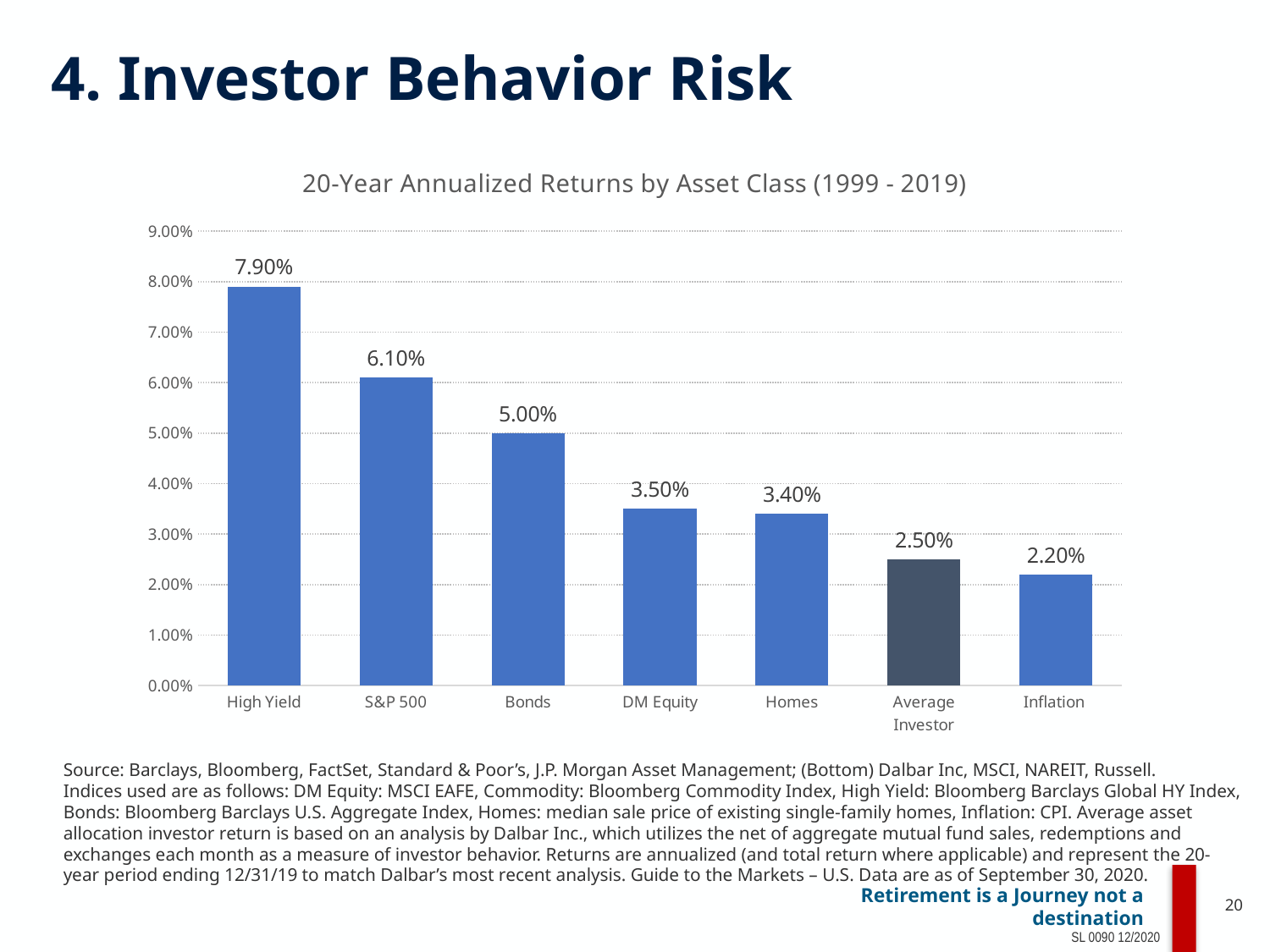
Which asset class has the highest 20-year annualized return? High Yield Which is larger, the return for Bonds or the return for DM Equity? Bonds What is the 20-year annualized return for High Yield? 7.90% What is the 20-year annualized return for the Average Investor? 2.50% Do the values rise or fall moving from left to right across the categories? Fall What kind of chart is shown on the slide? Bar chart Is the value for S&P 500 greater or less than 5.00%? greater What is the difference between the S&P 500 return and the Average Investor return? 3.60% Which category has the lowest value on the chart? Inflation What is the title of the chart? 20-Year Annualized Returns by Asset Class (1999 - 2019) What is the value shown for Homes? 3.40% How many asset classes are shown on the chart? 7